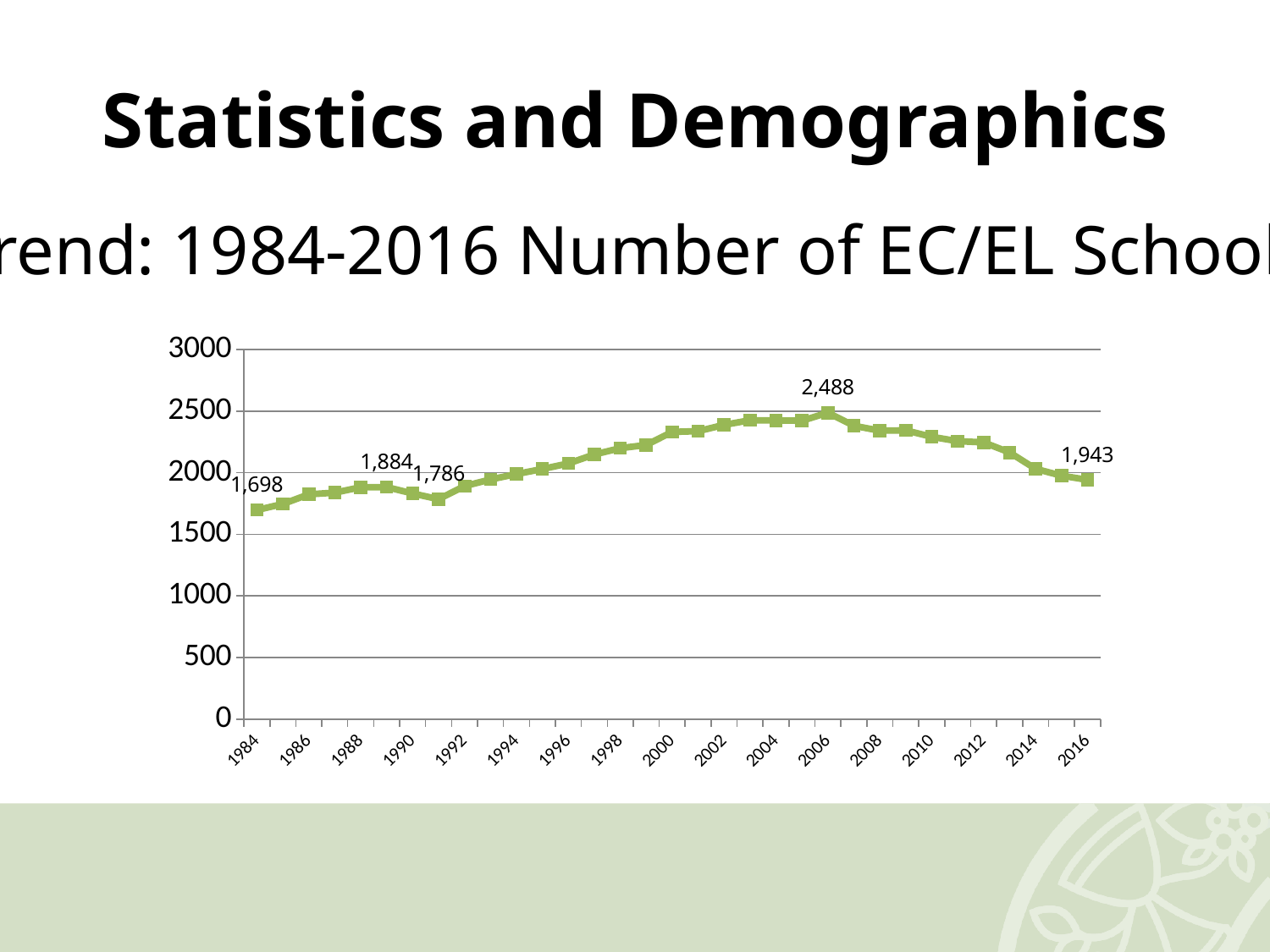
In which year does the line reach its peak? 2006 What is the highest value labelled on the line? 2,488 What colour is the plotted line? green What is the difference between the 2016 value and the 1984 value? 245 Is the value for 2000 greater or less than 2000? greater What is the number of EC/EL schools in 1984? 1,698 Does the line rise or fall between 2006 and 2016? fall What is the difference between the peak value in 2006 and the 1984 value? 790 In which year is the number of schools lowest? 1984 What is the number of EC/EL schools in 2016? 1,943 Which is larger, the value for 2016 or the value for 1984? 2016 What kind of chart is shown on the slide? line chart